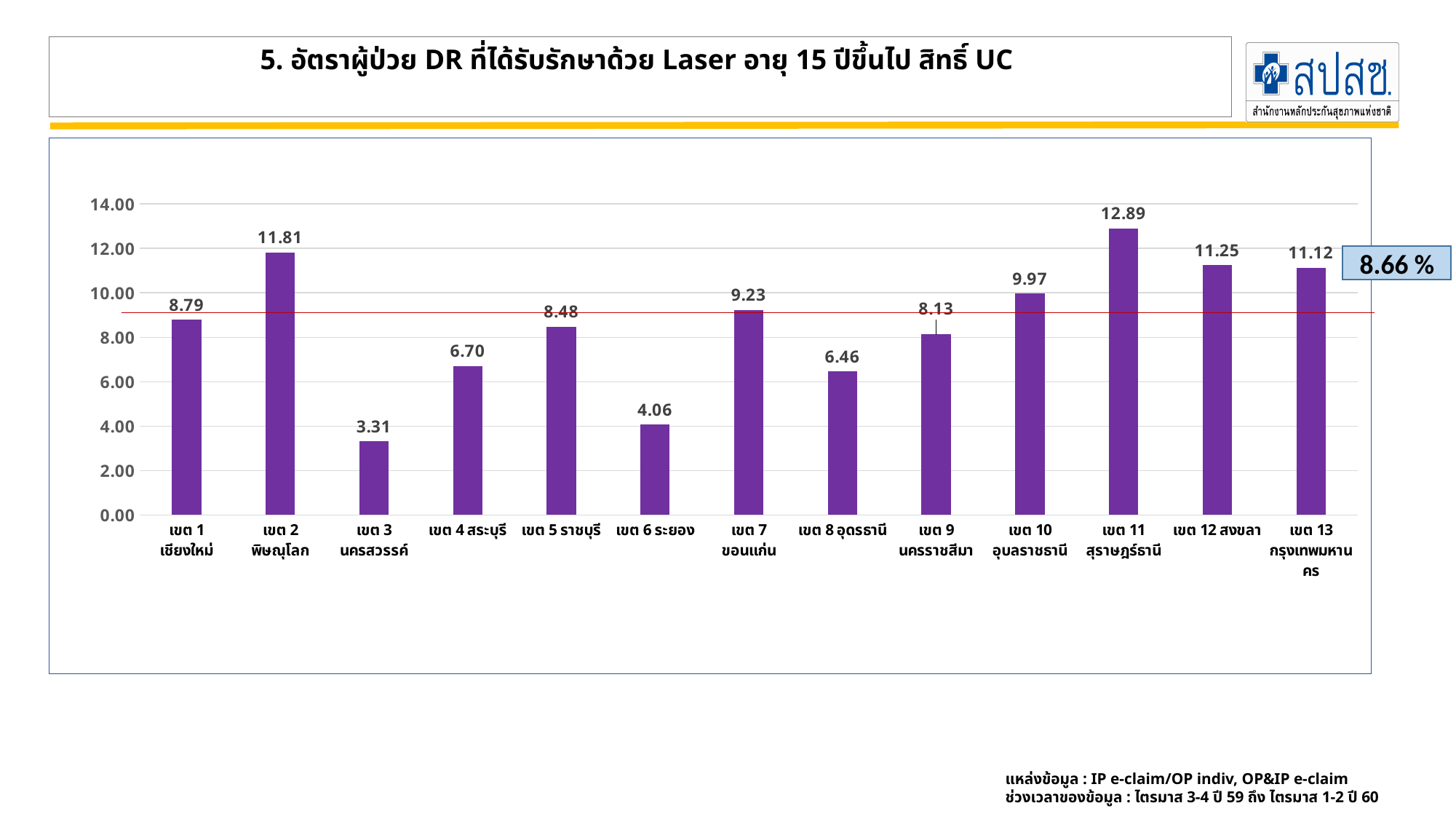
Which region has the lowest value? เขต 3 นครสวรรค์ What is the difference between the values for เขต 11 สุราษฎร์ธานี and เขต 3 นครสวรรค์? 9.58 What percentage is shown in the box next to the horizontal reference line? 8.66 % Which is larger, the value for เขต 4 สระบุรี or เขต 6 ระยอง? เขต 4 สระบุรี Is the value for เขต 12 สงขลา greater or less than 10.00? greater What kind of chart is shown on the slide? bar chart Which region has the highest value? เขต 11 สุราษฎร์ธานี What is the value for เขต 8 อุดรธานี? 6.46 What is the value for เขต 2 พิษณุโลก? 11.81 What is the value for เขต 13 กรุงเทพมหานคร? 11.12 How many regions are shown on the x axis? 13 What is the difference between the values for เขต 10 อุบลราชธานี and เขต 7 ขอนแก่น? 0.74